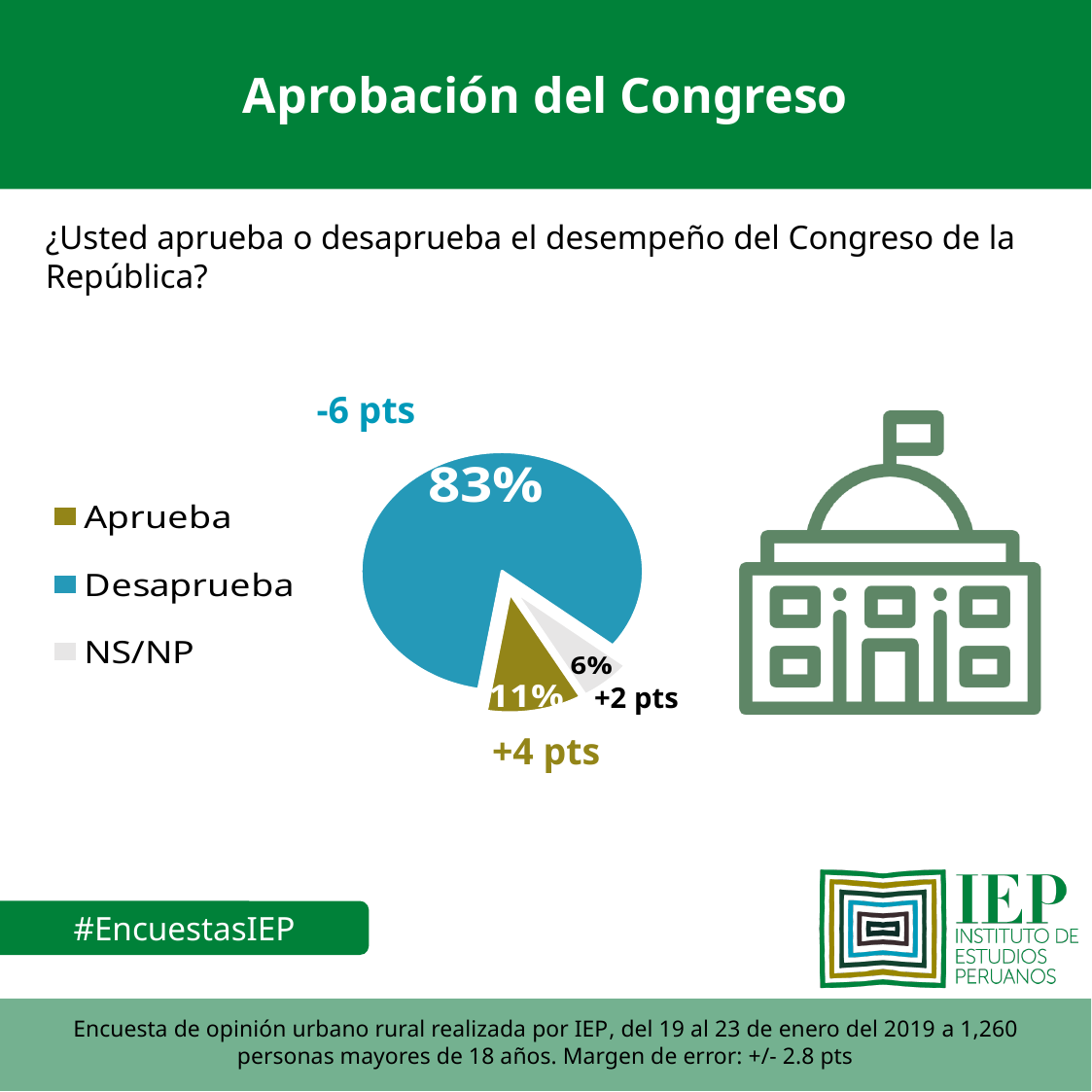
What percentage of respondents answered Aprueba? 11% What is the combined share of Aprueba and NS/NP? 17% What is the difference in percentage points between Desaprueba and Aprueba? 72 How many categories does the pie chart show? 3 What change in points is shown next to the Aprueba slice? +4 pts What kind of chart is shown on the slide? pie chart Which category has the largest share of the pie? Desaprueba Which is larger, the share for Aprueba or the share for NS/NP? Aprueba What change in points is shown next to the Desaprueba slice? -6 pts Which category has the smallest share of the pie? NS/NP What percentage of respondents answered NS/NP? 6% What percentage of respondents answered Desaprueba? 83%